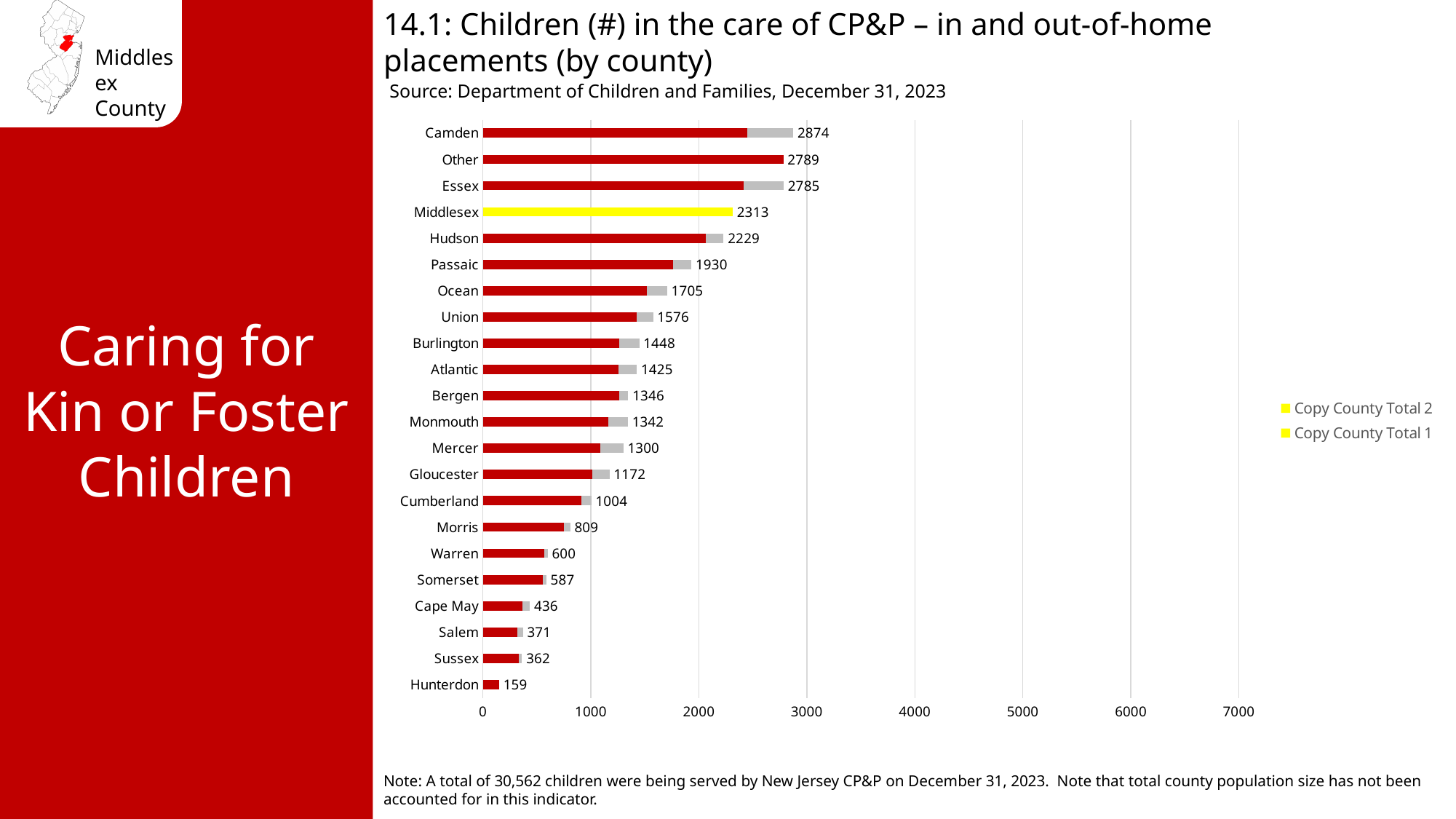
What is the difference between the values for Camden and Middlesex? 561 What is the value shown for Hudson? 2229 What kind of chart is shown on the slide? Bar chart How many series does the legend list? 2 What is the value shown for Middlesex? 2313 What colour is the bar for Middlesex? Yellow Which has a larger value, Passaic or Ocean? Passaic Which county has the highest value on the chart? Camden Is the value for Morris greater or less than 1000? less What is the value shown for Cumberland? 1004 How many counties (categories) are shown on the chart? 22 Which county has the lowest value on the chart? Hunterdon